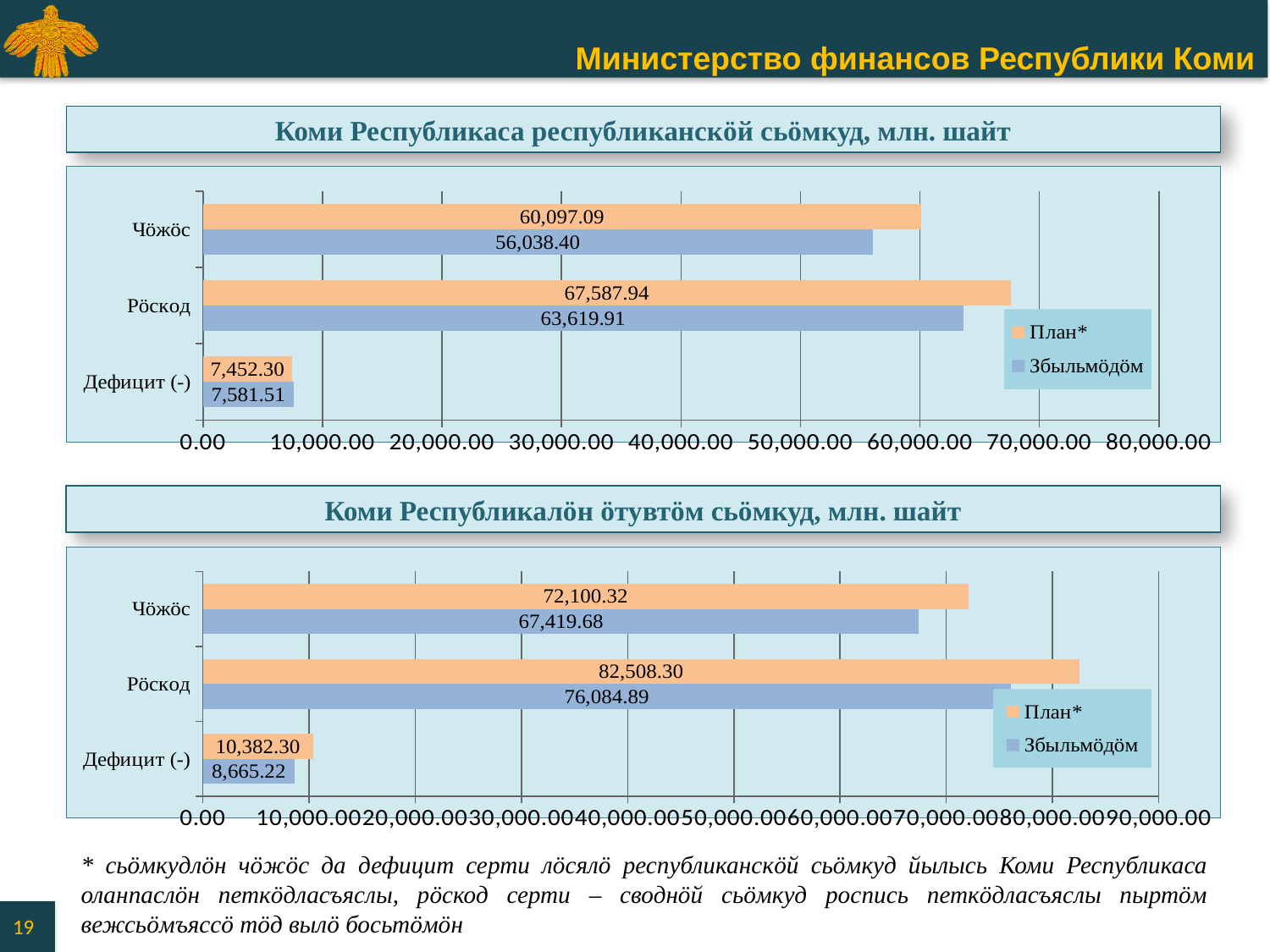
How many series does the legend of the top chart list? 2 In the top chart (Коми Республикаса республиканскöй сьöмкуд), what is the Збыльмöдöм value for Чöжöс? 56,038.40 In the bottom chart (Коми Республикалöн öтувтöм сьöмкуд), what is the План* value for Рöскод? 82,508.30 In the bottom chart (Коми Республикалöн öтувтöм сьöмкуд), which category has the highest Збыльмöдöм value? Рöскод In the bottom chart (Коми Республикалöн öтувтöм сьöмкуд), what is the difference between the План* and Збыльмöдöм values for Рöскод? 6,423.41 In the top chart (Коми Республикаса республиканскöй сьöмкуд), which category has the lowest План* value? Дефицит (-) In the top chart (Коми Республикаса республиканскöй сьöмкуд), which is larger for Дефицит (-): План* or Збыльмöдöм? Збыльмöдöм In the bottom chart (Коми Республикалöн öтувтöм сьöмкуд), what is the Збыльмöдöм value for Дефицит (-)? 8,665.22 In the top chart (Коми Республикаса республиканскöй сьöмкуд), what is the difference between the План* and Збыльмöдöм values for Чöжöс? 4,058.69 How many categories are shown in the bottom chart (Коми Республикалöн öтувтöм сьöмкуд)? 3 What type of chart is the bottom chart (Коми Республикалöн öтувтöм сьöмкуд)? Bar chart In the top chart (Коми Республикаса республиканскöй сьöмкуд), what is the План* value for Рöскод? 67,587.94